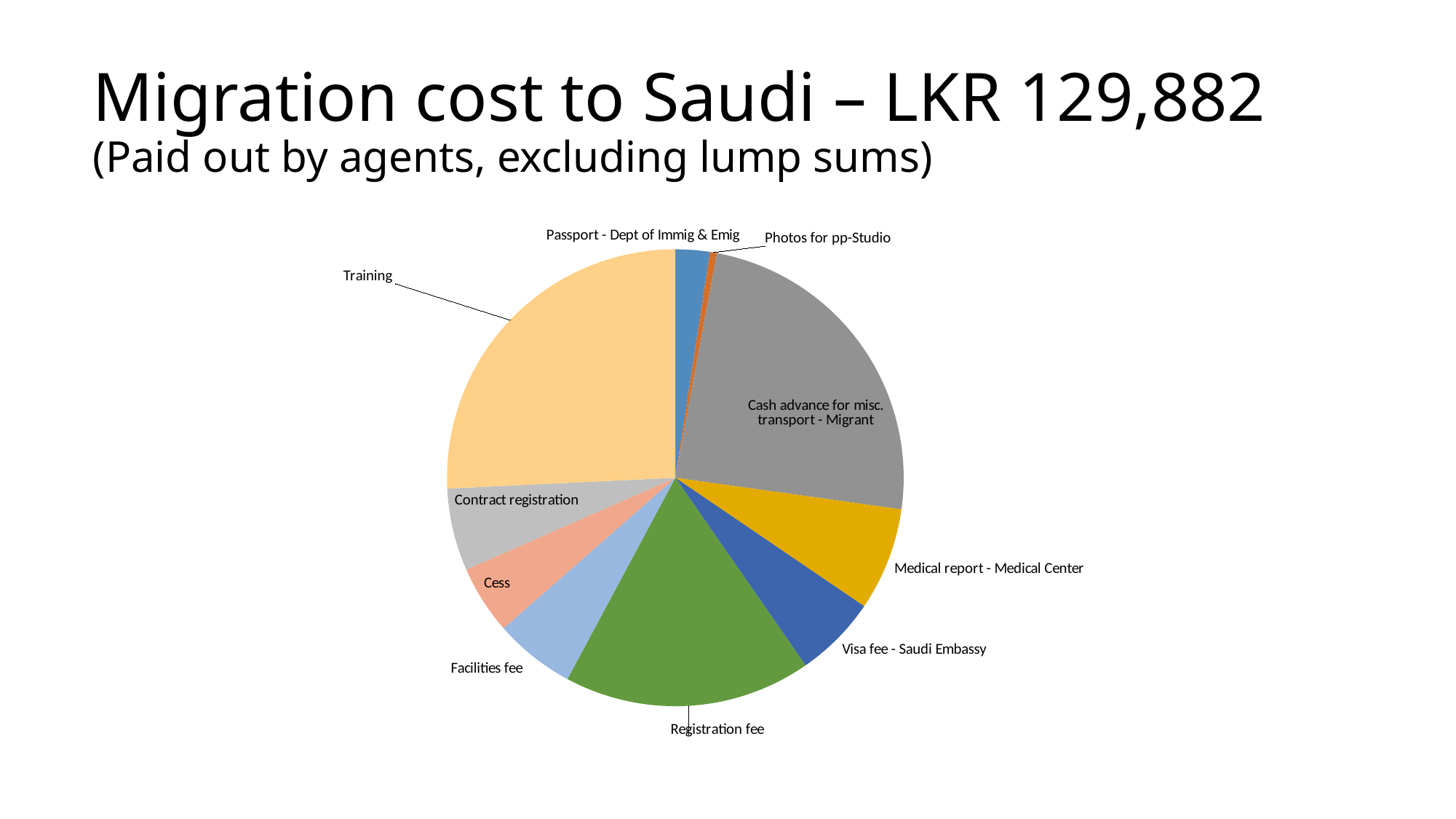
Which slice is larger, Registration fee or Visa fee - Saudi Embassy? Registration fee How many slices does the pie chart have? 10 Which slice is larger, Cash advance for misc. transport - Migrant or Visa fee - Saudi Embassy? Cash advance for misc. transport - Migrant What total migration cost is stated in the slide title? LKR 129,882 What colour is the Cash advance for misc. transport - Migrant slice? grey What kind of chart is shown on the slide? pie chart Which slice is larger, Registration fee or Facilities fee? Registration fee Which category has the smallest slice of the pie? Photos for pp-Studio